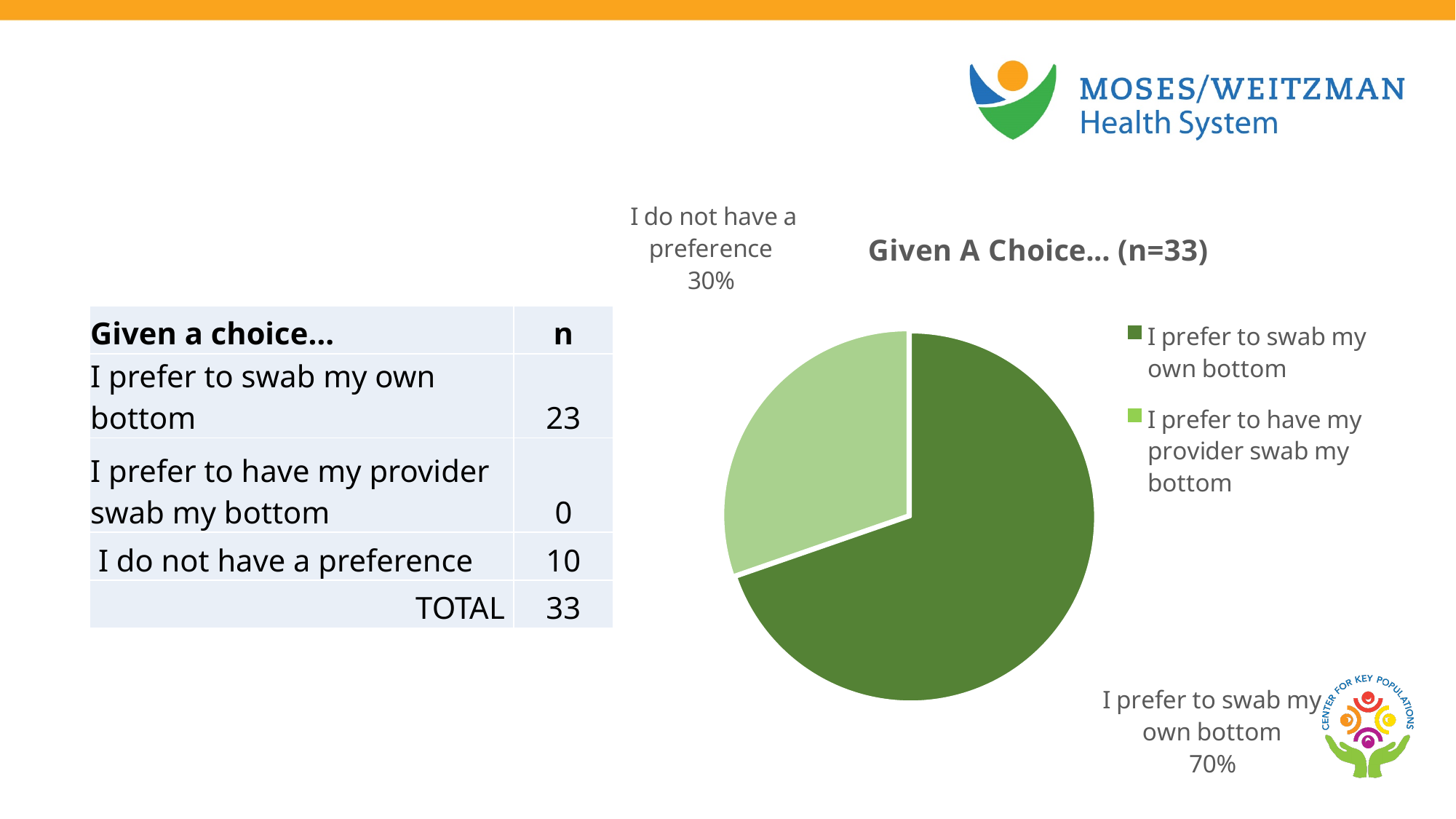
How many slices are visible in the pie chart? 2 In the pie chart, what percentage is shown for "I do not have a preference"? 30% Which labelled slice of the pie chart is the smallest? I do not have a preference What sample size (n) is given in the pie chart's title? 33 What is the difference in percentage points between the "I prefer to swab my own bottom" slice and the "I do not have a preference" slice? 40 Which slice of the pie chart is the largest? I prefer to swab my own bottom In the pie chart, which is larger: the share for "I prefer to swab my own bottom" or the share for "I do not have a preference"? I prefer to swab my own bottom In the pie chart, what percentage is shown for "I prefer to swab my own bottom"? 70% What kind of chart is shown on the slide? pie chart What is the title of the pie chart? Given A Choice… (n=33) Is the share for "I do not have a preference" in the pie chart greater or less than 50%? less How many entries does the pie chart's legend list? 2